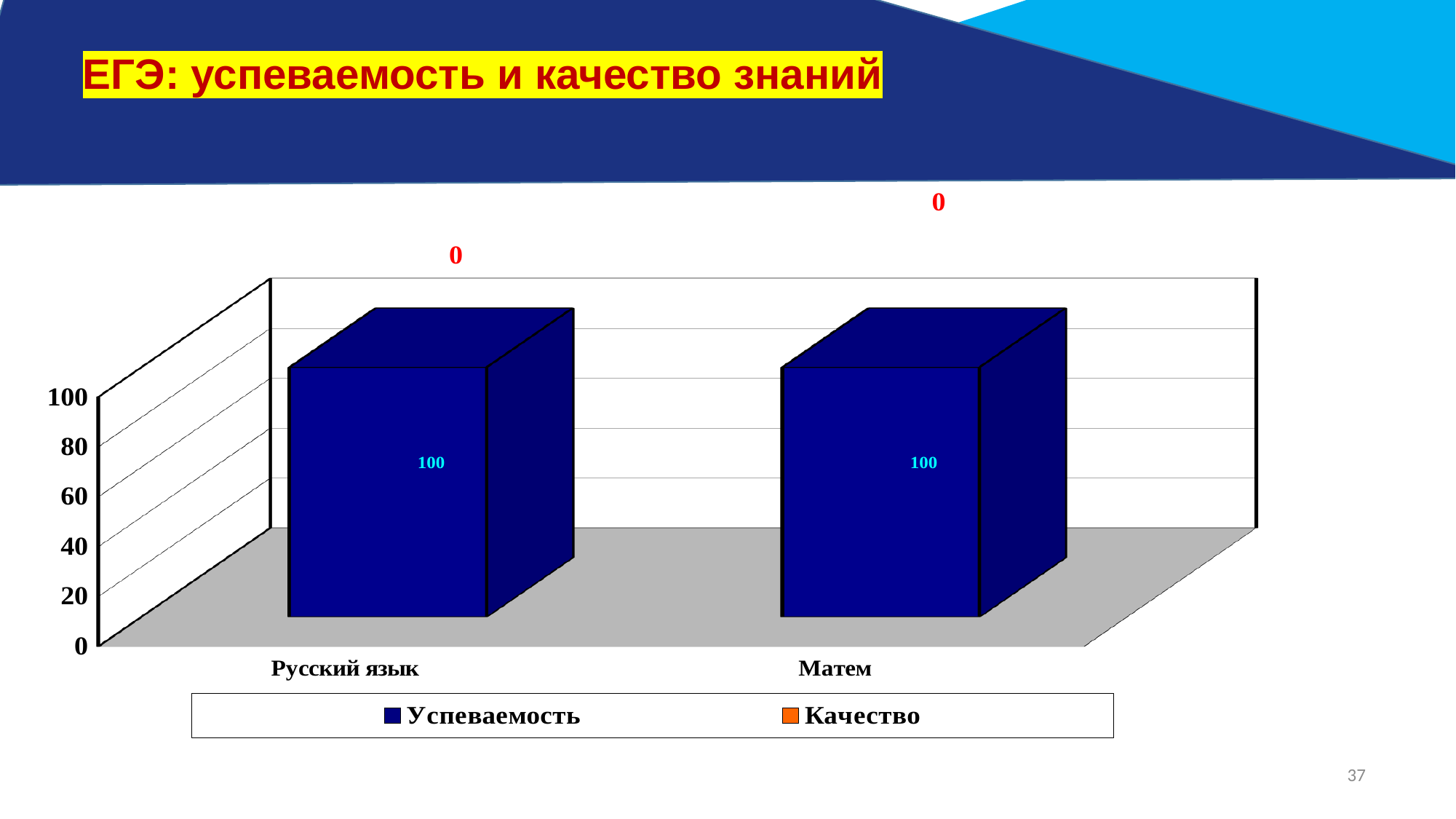
How many categories are shown on the x axis? 2 Is the value of Успеваемость for Русский язык greater or less than 80? greater What is the value of Качество for Русский язык? 0 What is the value of Успеваемость for Матем? 100 How many series does the legend list? 2 What kind of chart is shown on the slide? bar chart What is the value of Успеваемость for Русский язык? 100 Which is larger for Матем, Успеваемость or Качество? Успеваемость Which colour represents the Успеваемость series in the legend? blue What is the title of the slide? ЕГЭ: успеваемость и качество знаний What is the difference between Успеваемость and Качество for Русский язык? 100 What is the value of Качество for Матем? 0